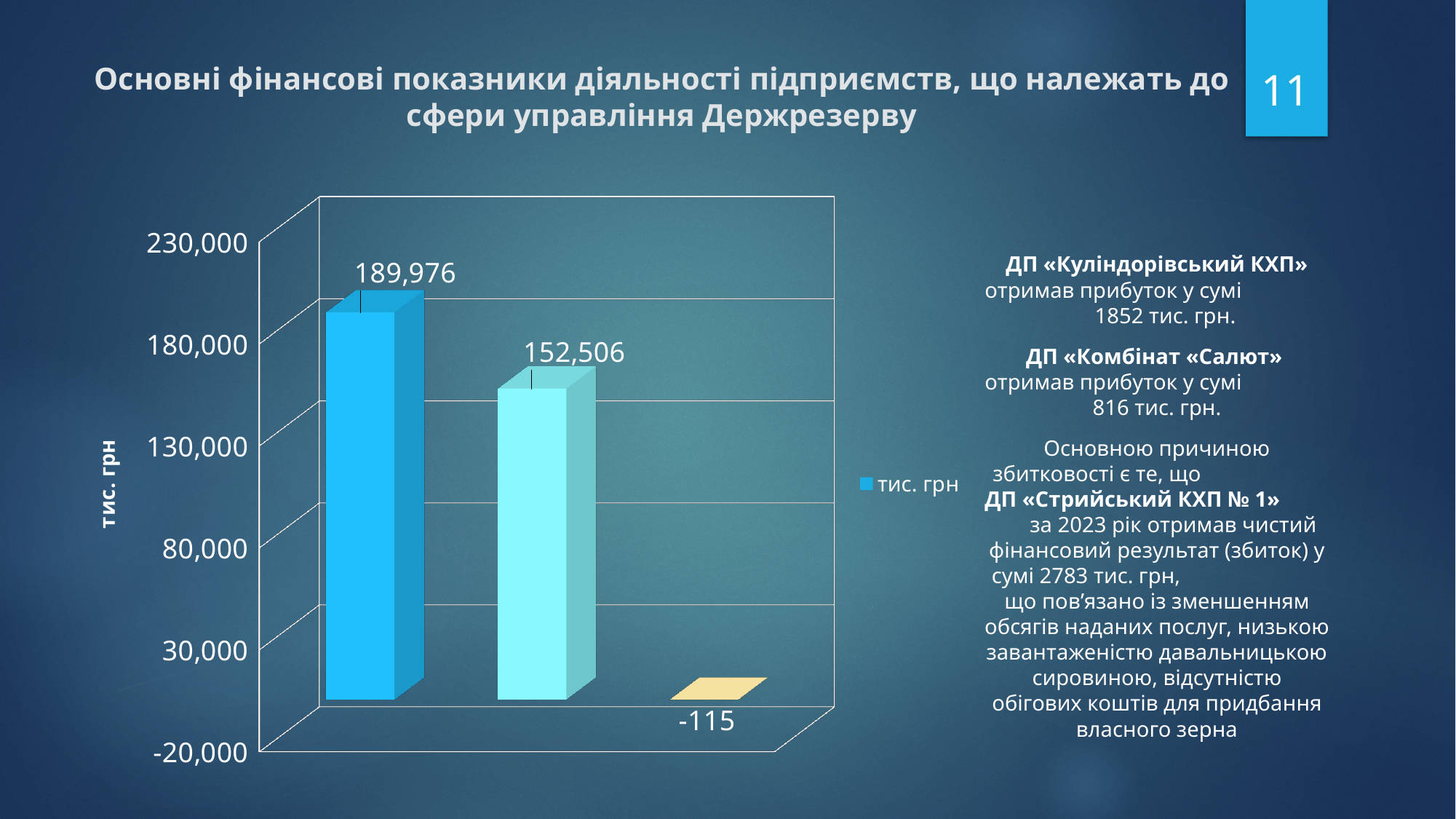
What is the value shown on the data label of the third (rightmost) bar? -115 What is the value shown on the data label of the first (leftmost) bar? 189,976 What is the legend entry of the chart? тис. грн What kind of chart is shown on the slide? bar chart Which bar has the highest value: the first, second or third? the first What is the value shown on the data label of the middle bar? 152,506 Which bar has the lowest value: the first, second or third? the third How many series does the legend list? 1 How many bars are plotted in the chart? 3 Which is larger, the value of the middle bar or the value of the rightmost bar? the middle bar What is the difference between the values of the first bar and the middle bar? 37,470 Is the value of the middle bar greater or less than 130,000? greater